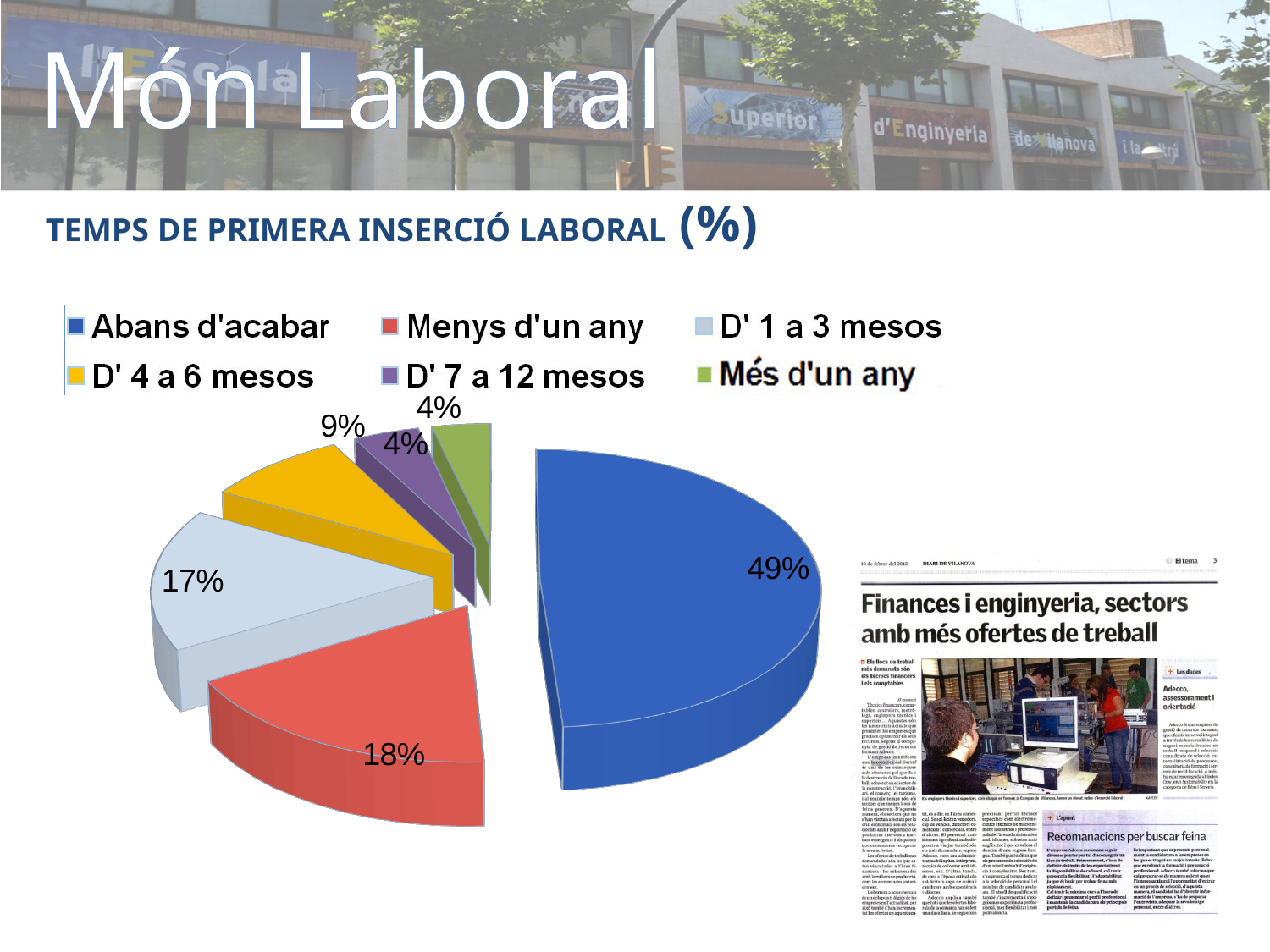
What is the difference in percentage points between 'D' 1 a 3 mesos' and 'D' 4 a 6 mesos'? 8 What colour is the slice for 'Més d'un any'? Green What is the title of the chart? TEMPS DE PRIMERA INSERCIÓ LABORAL (%) Which is larger, 'Menys d'un any' or 'D' 1 a 3 mesos'? Menys d'un any How many categories does the legend list? 6 What percentage is shown for 'Abans d'acabar'? 49% What is the difference in percentage points between 'Abans d'acabar' and 'Menys d'un any'? 31 What percentage is shown for 'Menys d'un any'? 18% Which category has the largest share of the pie? Abans d'acabar What type of chart is shown on the slide? Pie chart What percentage is shown for 'D' 4 a 6 mesos'? 9% What percentage is shown for 'D' 1 a 3 mesos'? 17%